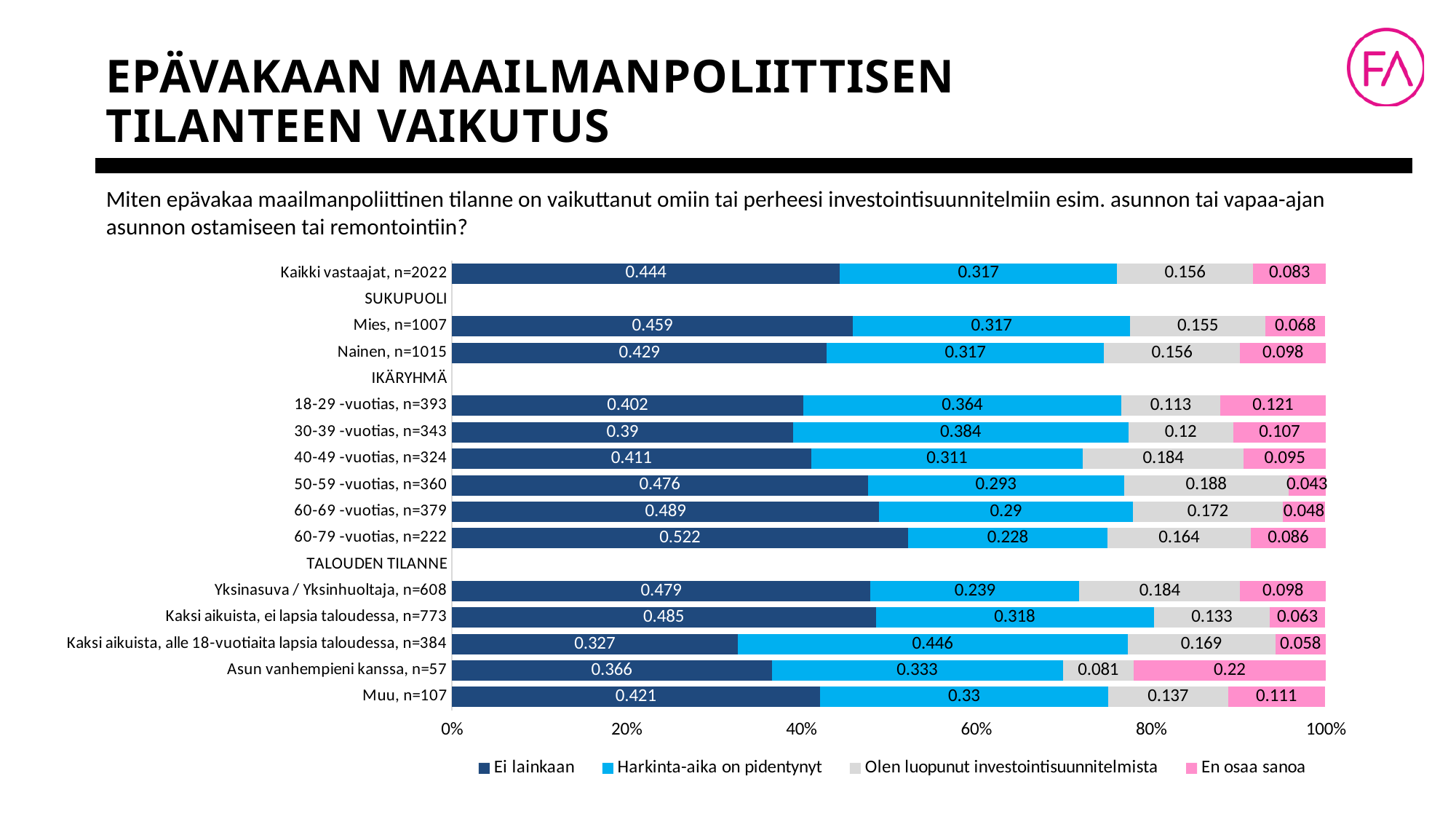
What is the value of "Olen luopunut investointisuunnitelmista" for 50-59 -vuotias, n=360? 0.188 What is the value of "Ei lainkaan" for Kaikki vastaajat, n=2022? 0.444 What is the value of "En osaa sanoa" for Asun vanhempieni kanssa, n=57? 0.22 Which category has the highest value for "Ei lainkaan"? 60-79 -vuotias, n=222 How many series does the legend list? 4 Which has a larger "Harkinta-aika on pidentynyt" value: 18-29 -vuotias, n=393 or 30-39 -vuotias, n=343? 30-39 -vuotias, n=343 What kind of chart is shown on the slide? Stacked bar chart Which category has the lowest value for "En osaa sanoa"? 50-59 -vuotias, n=360 Which category has the lowest value for "Ei lainkaan"? Kaksi aikuista, alle 18-vuotiaita lapsia taloudessa, n=384 What colour represents the "En osaa sanoa" series? Pink What is the value of "Harkinta-aika on pidentynyt" for Kaksi aikuista, alle 18-vuotiaita lapsia taloudessa, n=384? 0.446 What is the difference between the "Ei lainkaan" values for Mies, n=1007 and Nainen, n=1015? 0.03